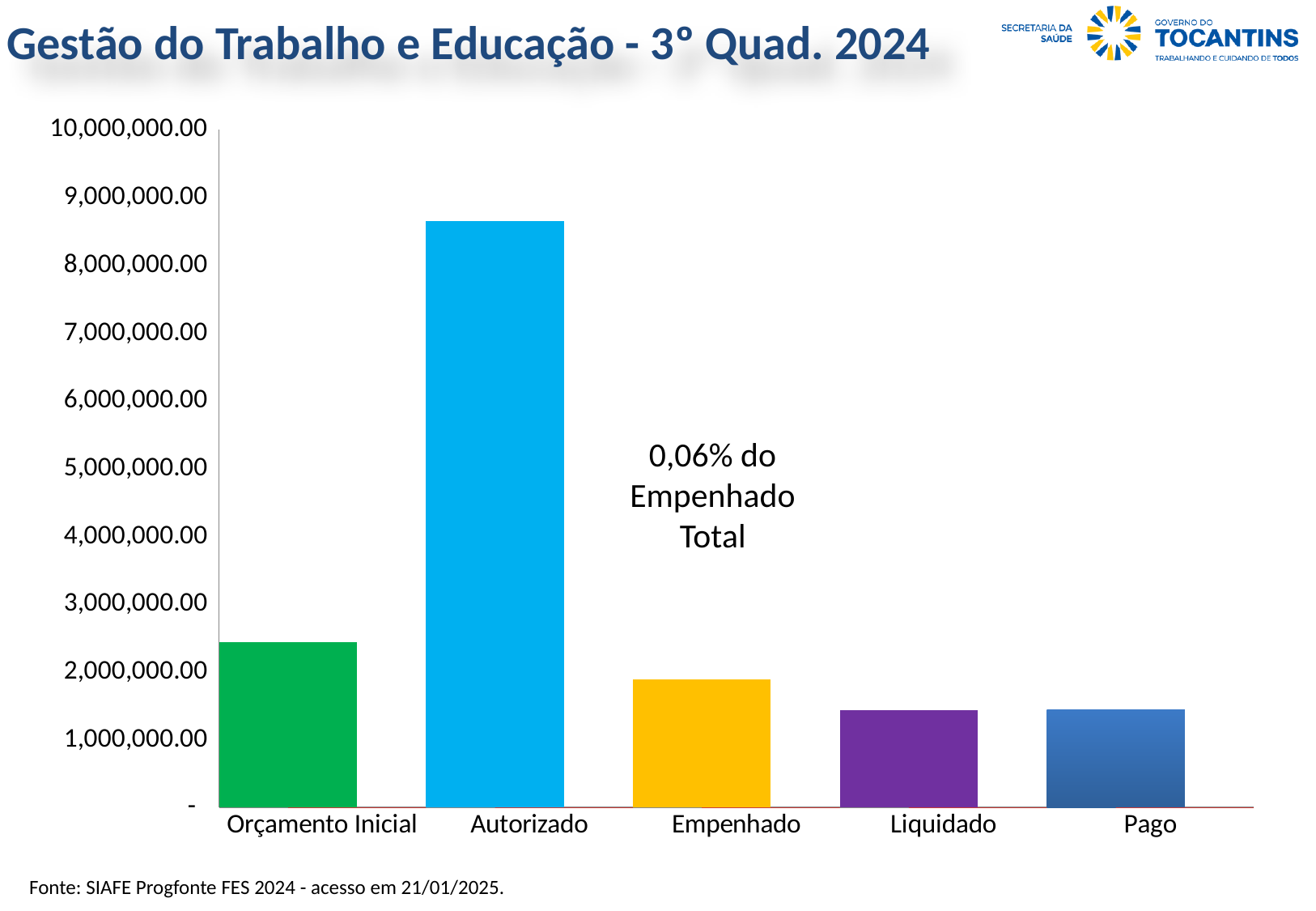
Is the value for Pago greater or less than 2,000,000.00? less Which is larger, the value for Autorizado or the value for Orçamento Inicial? Autorizado Is the value for Liquidado greater or less than 1,000,000.00? greater What kind of chart is shown on the slide? bar chart Which category has the highest value? Autorizado Is the value for Orçamento Inicial greater or less than 2,000,000.00? greater Which is larger, the value for Orçamento Inicial or the value for Empenhado? Orçamento Inicial How many categories are plotted on the x axis? 5 What is the title of the slide containing the chart? Gestão do Trabalho e Educação - 3° Quad. 2024 What percentage is stated in the annotation text inside the chart area? 0,06%